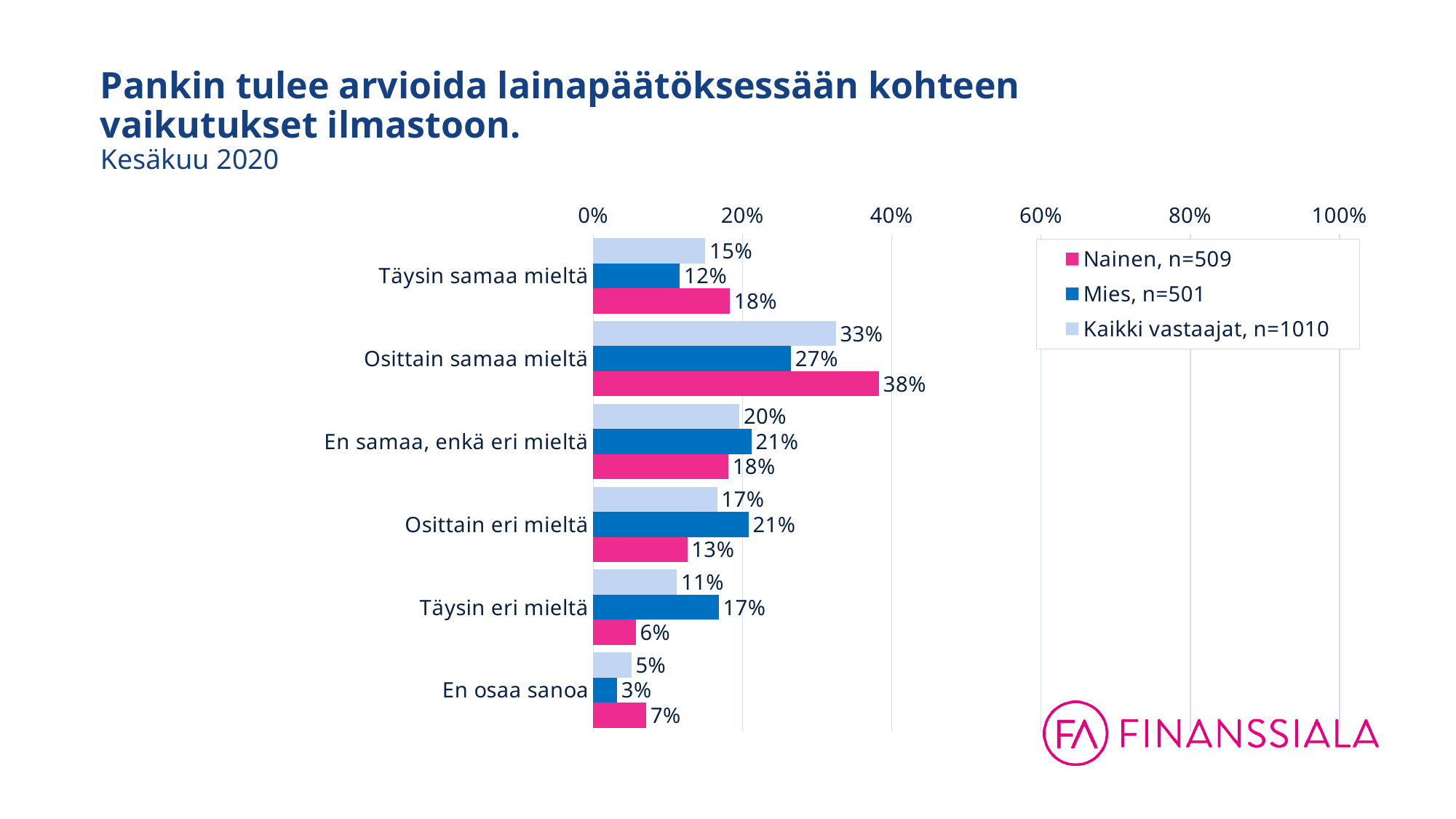
How many categories are shown on the chart? 6 Which series is shown in pink in the legend? Nainen, n=509 In the Osittain eri mieltä category, which is larger: the value for Nainen, n=509 or for Mies, n=501? Mies, n=501 What is the difference between the Nainen, n=509 and Mies, n=501 values in the Täysin eri mieltä category? 11% What kind of chart is shown on the slide? Bar chart Is the value for Nainen, n=509 in the Osittain samaa mieltä category greater or less than 40%? less What is the value for Mies, n=501 in the Täysin eri mieltä category? 17% Which category has the lowest value for Mies, n=501? En osaa sanoa What is the value for Nainen, n=509 in the Osittain samaa mieltä category? 38% Which category has the highest value for Kaikki vastaajat, n=1010? Osittain samaa mieltä What is the value for Kaikki vastaajat, n=1010 in the En osaa sanoa category? 5% How many series does the legend list? 3